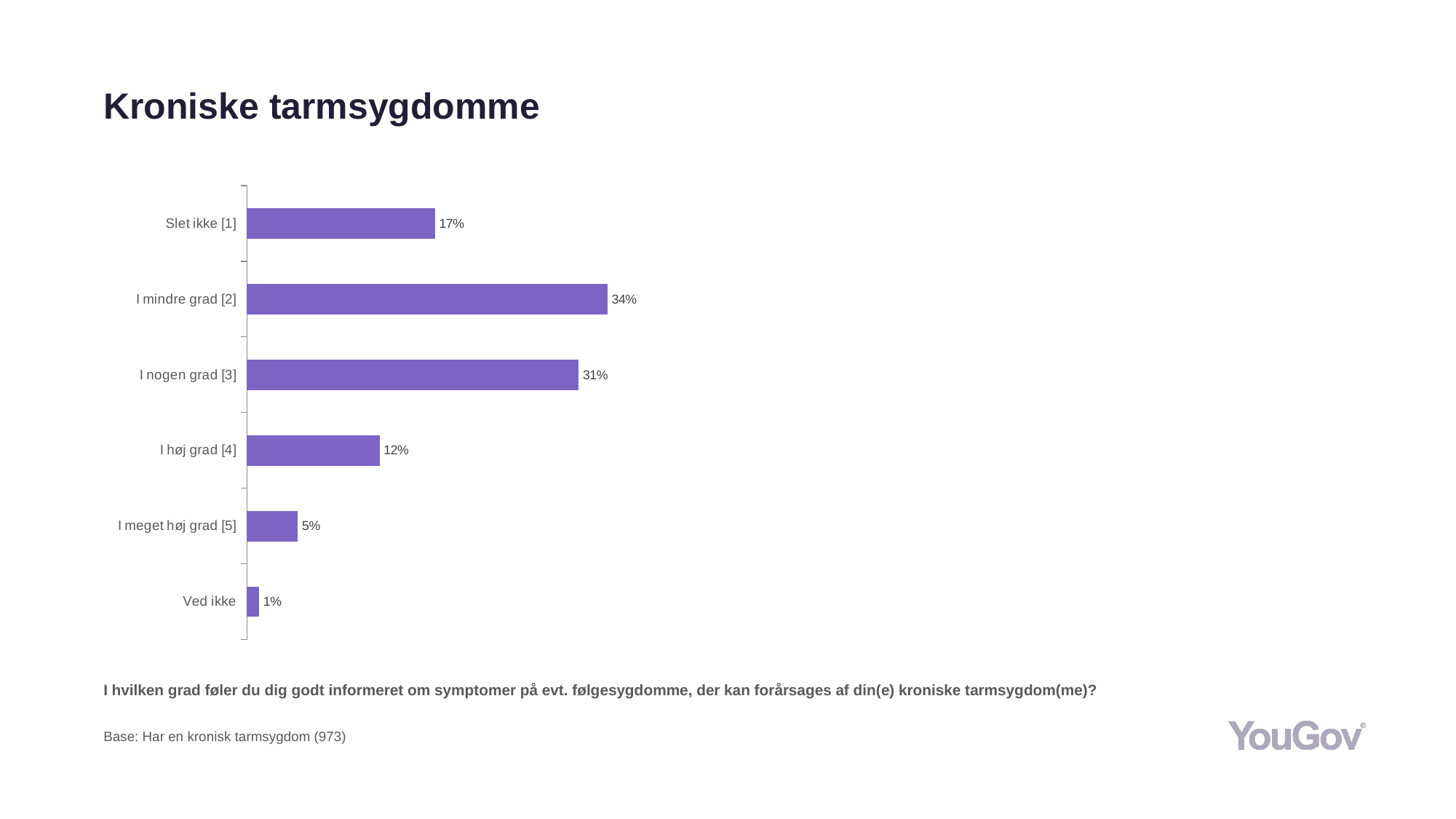
What is the difference between the values for "I mindre grad [2]" and "I nogen grad [3]"? 3% What is the value for "I mindre grad [2]"? 34% How many categories are shown in the chart? 6 What is the title of the slide? Kroniske tarmsygdomme What is the value for "Ved ikke"? 1% Which category has the lowest value? Ved ikke What is the difference between the values for "Slet ikke [1]" and "I høj grad [4]"? 5% Which category has the highest value? I mindre grad [2] What is the value for "I meget høj grad [5]"? 5% What is the value for "Slet ikke [1]"? 17% Which is larger, the value for "I nogen grad [3]" or the value for "I høj grad [4]"? I nogen grad [3] What kind of chart is shown on the slide? Bar chart